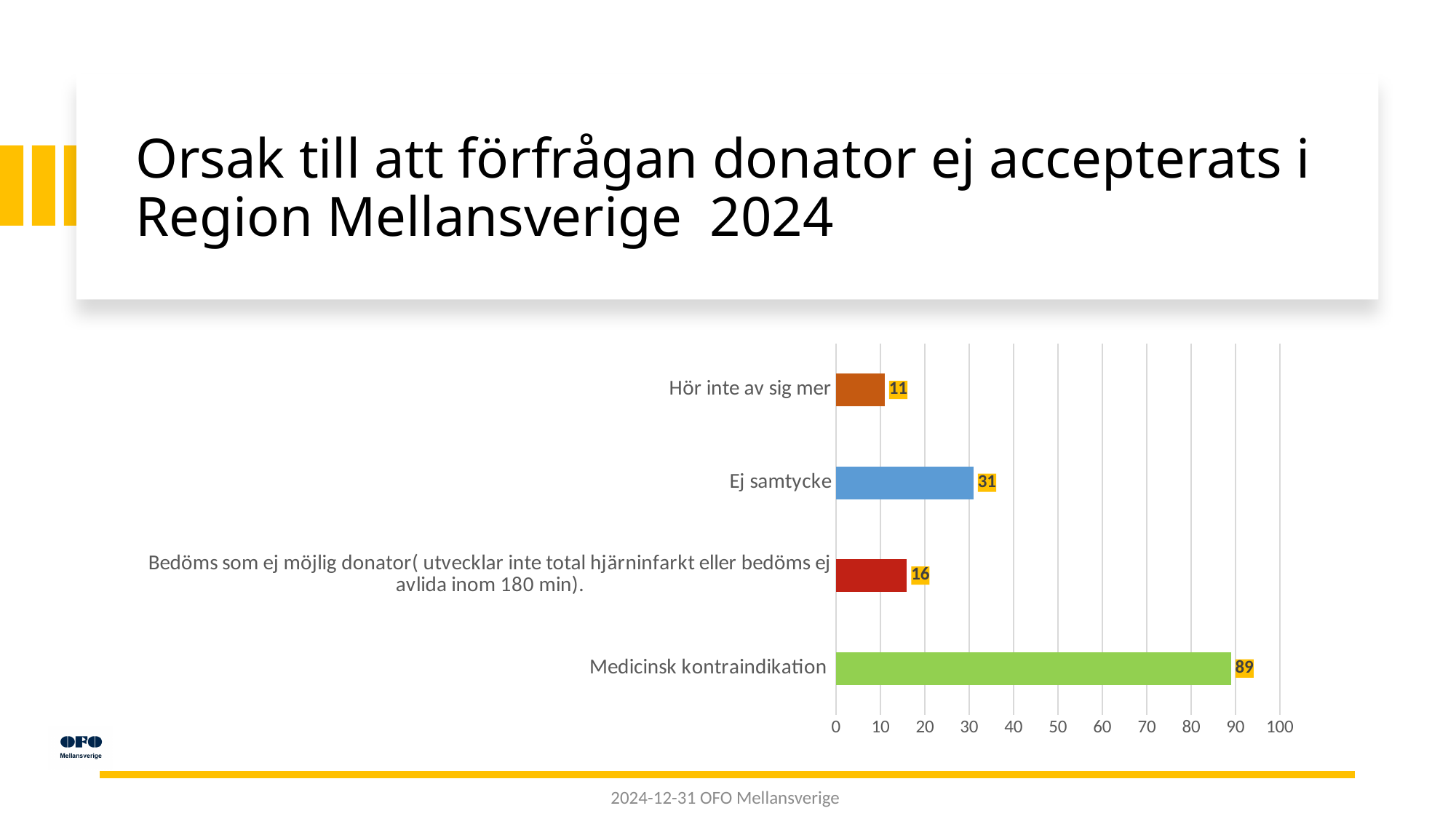
What is the difference between the values for Ej samtycke and Hör inte av sig mer? 20 What kind of chart is shown on the slide? Bar chart What is the value for the category 'Bedöms som ej möjlig donator( utvecklar inte total hjärninfarkt eller bedöms ej avlida inom 180 min).'? 16 Which category has the highest value? Medicinsk kontraindikation What is the value for Hör inte av sig mer? 11 How many categories are shown in the chart? 4 What is the value for Medicinsk kontraindikation? 89 Is the value for Medicinsk kontraindikation greater or less than 80? greater What is the value for Ej samtycke? 31 Which is larger, the value for Ej samtycke or the value for Hör inte av sig mer? Ej samtycke What is the difference between the values for Medicinsk kontraindikation and Ej samtycke? 58 Which category has the lowest value? Hör inte av sig mer